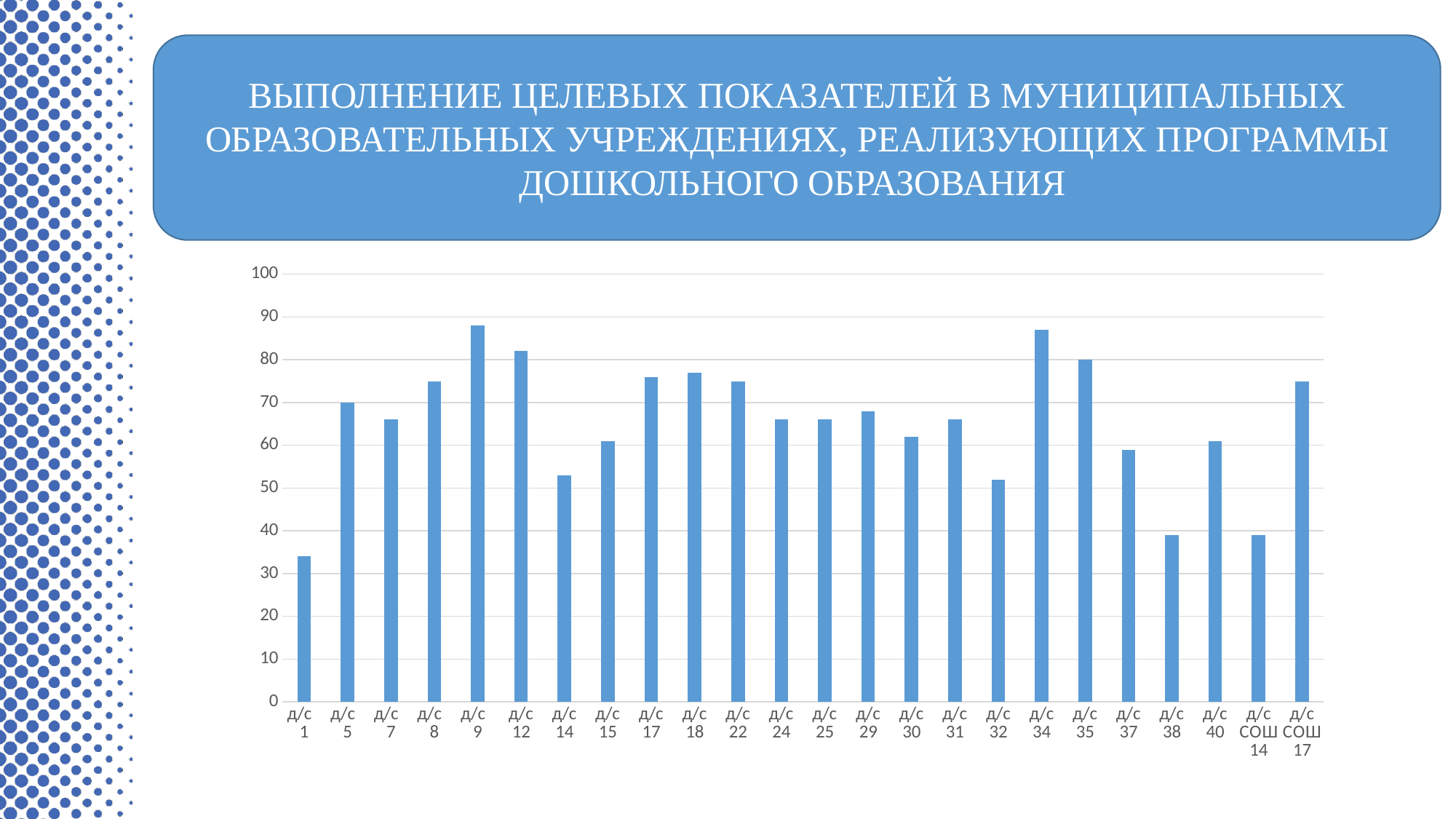
Is the value for д/с 1 greater or less than 40? less Which is larger, the value for д/с 5 or the value for д/с 1? д/с 5 Which is larger, the value for д/с 34 or the value for д/с 32? д/с 34 Is the value for д/с 32 greater or less than 60? less What kind of chart is shown on the slide? bar chart How many categories are plotted along the x axis of the chart? 24 Is the value for д/с 40 greater or less than 50? greater What is the highest value shown on the vertical axis of the chart? 100 Which category has the lowest bar in the chart? д/с 1